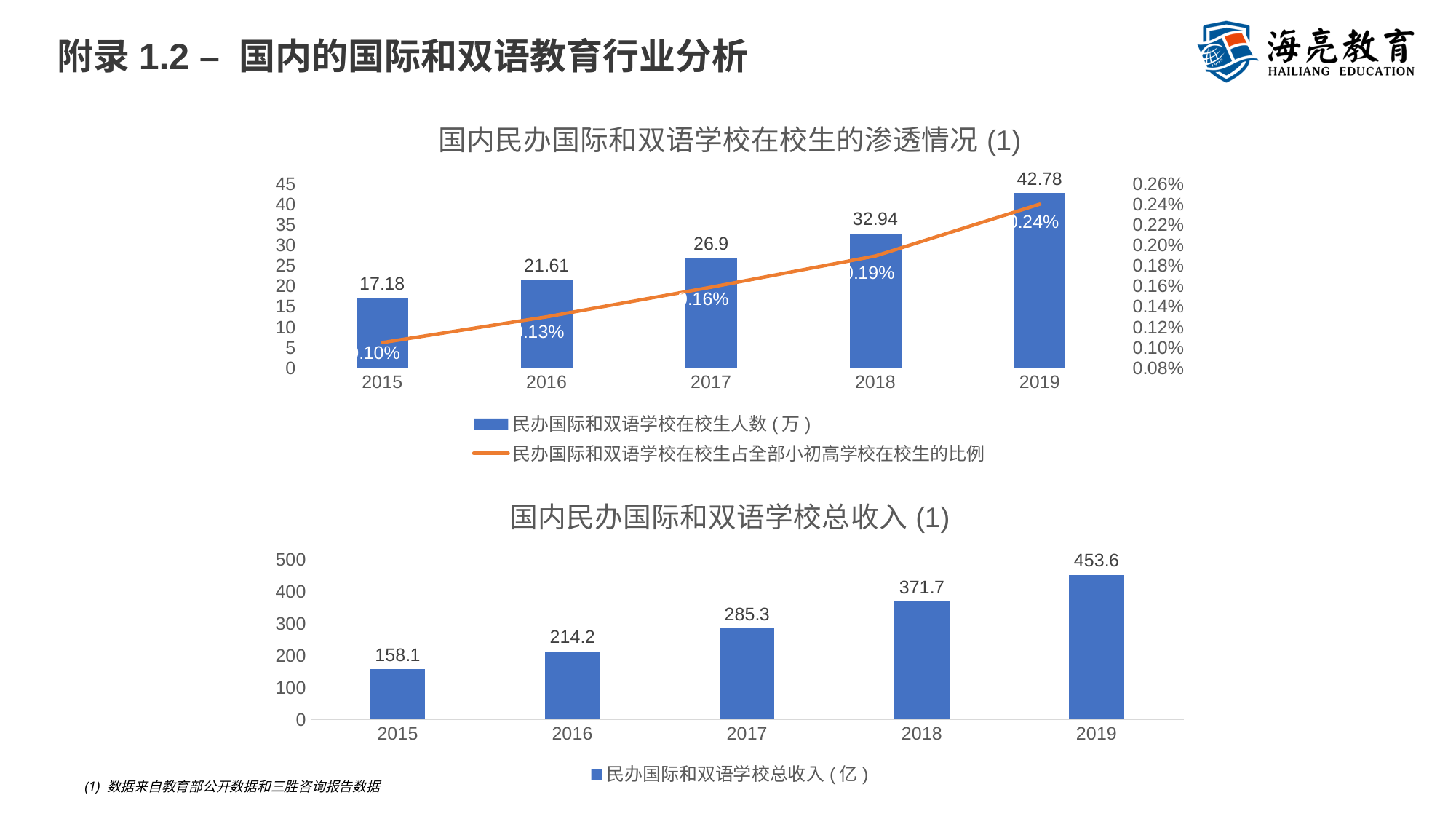
In the top chart (国内民办国际和双语学校在校生的渗透情况), what is the difference in student numbers (万) between 2019 and 2018? 9.84 In the bottom chart (国内民办国际和双语学校总收入), what is the difference in revenue (亿) between 2016 and 2015? 56.1 In the bottom chart (国内民办国际和双语学校总收入), which year has the highest total revenue? 2019 In the bottom chart (国内民办国际和双语学校总收入), how many years are shown on the x axis? 5 In the top chart (国内民办国际和双语学校在校生的渗透情况), what is the number of students (万) in 2019? 42.78 In the bottom chart (国内民办国际和双语学校总收入), what is the total revenue (亿) in 2017? 285.3 In the top chart (国内民办国际和双语学校在校生的渗透情况), does the penetration ratio rise or fall from 2015 to 2019? rise What kind of chart is the bottom chart (国内民办国际和双语学校总收入)? bar chart In the top chart (国内民办国际和双语学校在校生的渗透情况), which year has the lowest number of students? 2015 In the top chart (国内民办国际和双语学校在校生的渗透情况), what is the penetration ratio shown for 2017? 0.16% In the bottom chart (国内民办国际和双语学校总收入), is the revenue for 2018 greater or less than 300? greater In the top chart (国内民办国际和双语学校在校生的渗透情况), how many series does the legend list? 2